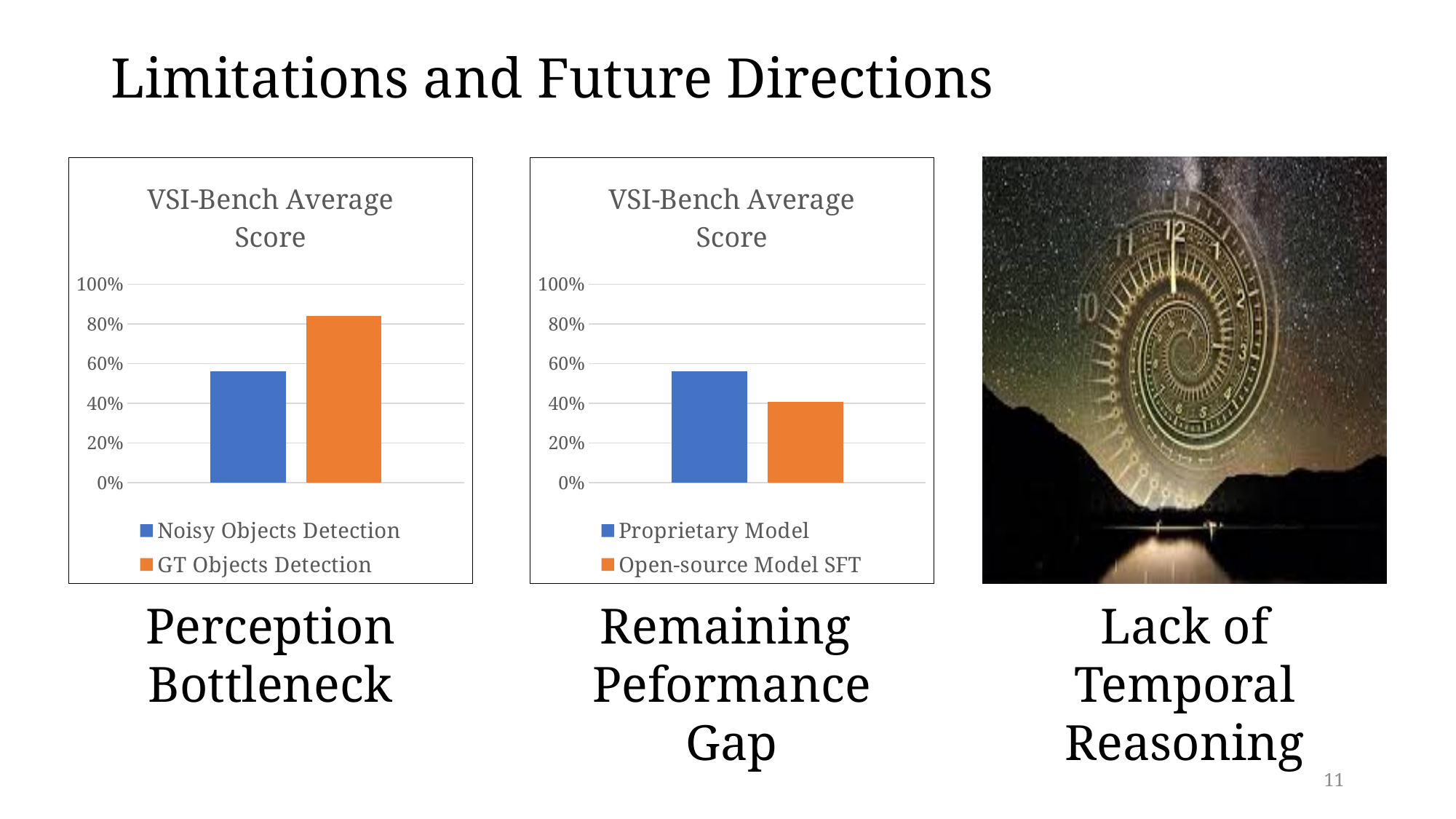
On the middle chart (under 'Remaining Peformance Gap'), what colour is the bar for Open-source Model SFT? orange On the middle chart (under 'Remaining Peformance Gap'), what is the chart title? VSI-Bench Average Score On the left chart (under 'Perception Bottleneck'), which series has the lowest value? Noisy Objects Detection On the middle chart (under 'Remaining Peformance Gap'), is the value for Open-source Model SFT greater or less than 60%? less On the left chart (under 'Perception Bottleneck'), how many series does the legend list? 2 On the middle chart (under 'Remaining Peformance Gap'), which series has the higher value, Proprietary Model or Open-source Model SFT? Proprietary Model On the left chart (under 'Perception Bottleneck'), what kind of chart is shown? bar chart On the left chart (under 'Perception Bottleneck'), is the value for Noisy Objects Detection greater or less than 60%? less On the middle chart (under 'Remaining Peformance Gap'), how many bars are plotted? 2 On the left chart (under 'Perception Bottleneck'), is the value for GT Objects Detection greater or less than 80%? greater On the left chart (under 'Perception Bottleneck'), which series has the higher value, Noisy Objects Detection or GT Objects Detection? GT Objects Detection